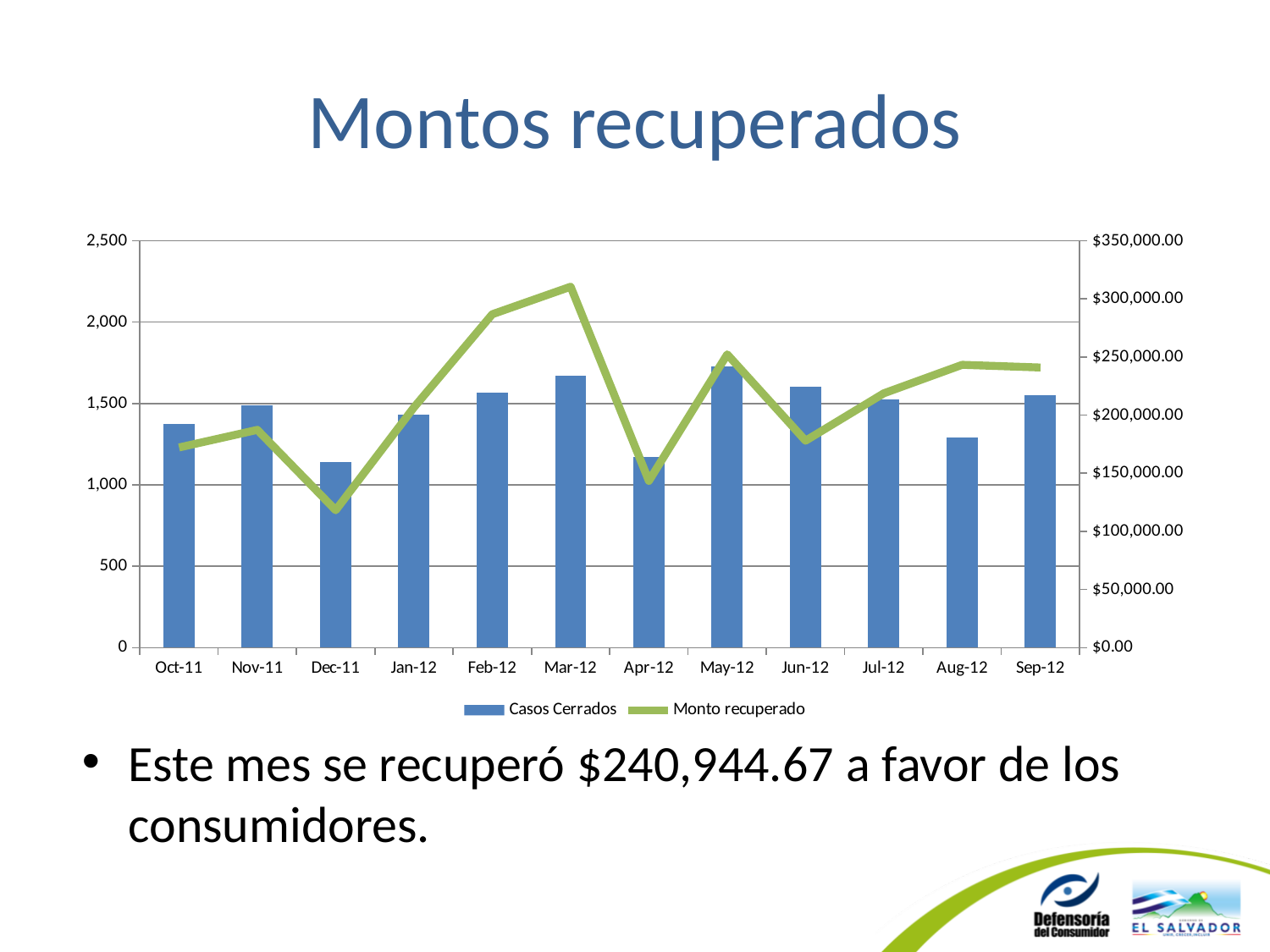
Is the Monto recuperado value for Mar-12 greater or less than $300,000.00? greater Does Monto recuperado rise or fall from Dec-11 to Mar-12? rise How many series does the chart legend list? 2 What kind of chart is shown on the slide? A bar chart combined with a line chart What is the title of the slide containing the chart? Montos recuperados Which series is drawn as a line in the chart? Monto recuperado In which month is Monto recuperado lowest? Dec-11 Which month has more Casos Cerrados, Nov-11 or Dec-11? Nov-11 Is the Casos Cerrados value for Aug-12 greater or less than 1,500? less In which month is Monto recuperado highest? Mar-12 How many months are shown on the x axis of the chart? 12 Is the Casos Cerrados value for Dec-11 greater or less than 1,500? less